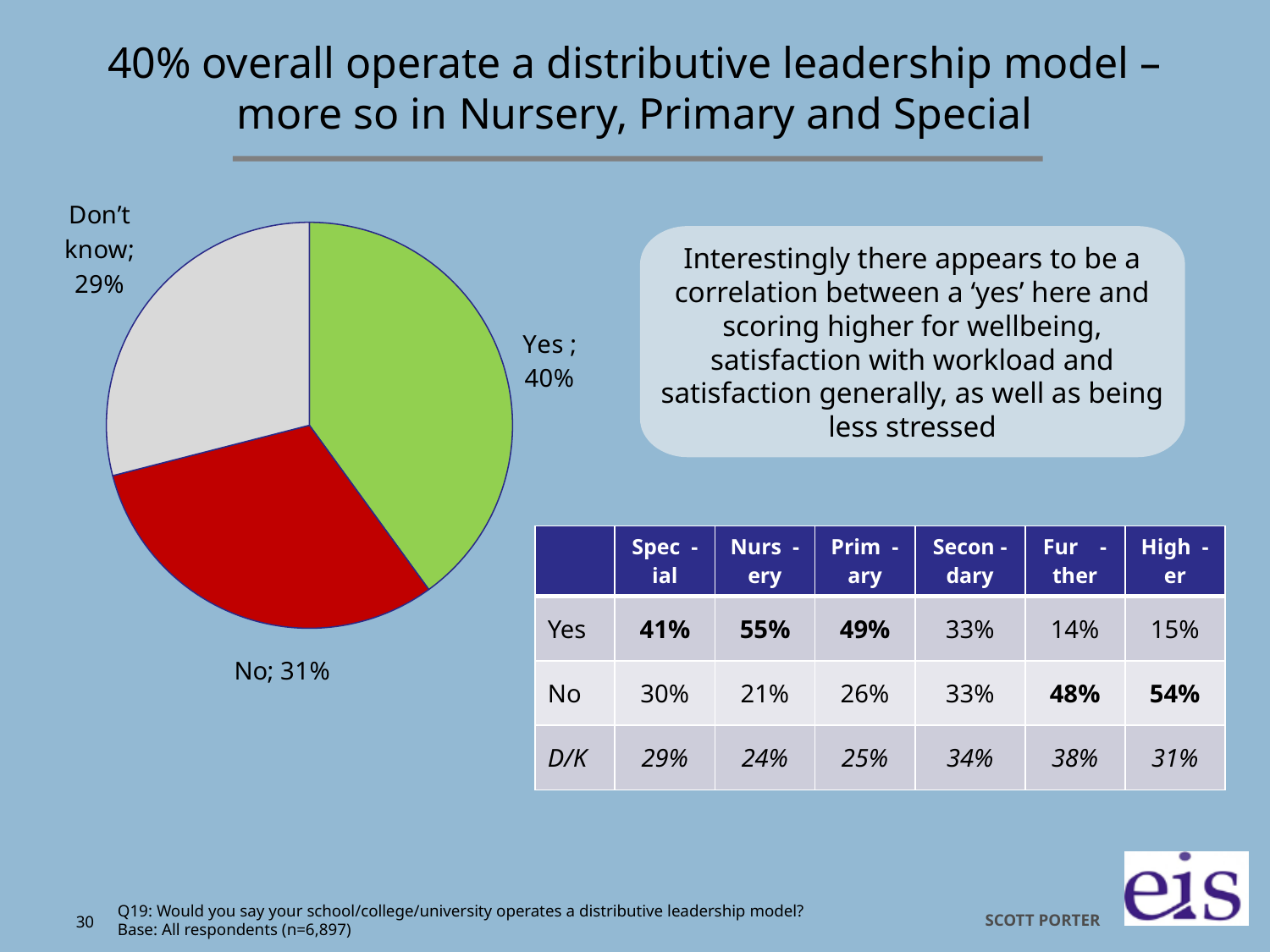
What is the difference in percentage points between the 'No' and 'Don't know' slices in the pie chart? 2 How many slices does the pie chart have? 3 What percentage of respondents answered 'No' in the pie chart? 31% What colour is the 'Yes' slice in the pie chart? green What colour is the 'No' slice in the pie chart? red Which response has the smallest slice in the pie chart? Don't know Is the 'Yes' slice or the 'Don't know' slice larger in the pie chart? Yes Which response has the largest slice in the pie chart? Yes What percentage of respondents answered 'Yes' in the pie chart? 40% What percentage of respondents answered 'Don't know' in the pie chart? 29% What is the difference in percentage points between the 'Yes' and 'No' slices in the pie chart? 9 What kind of chart is shown on the slide? pie chart